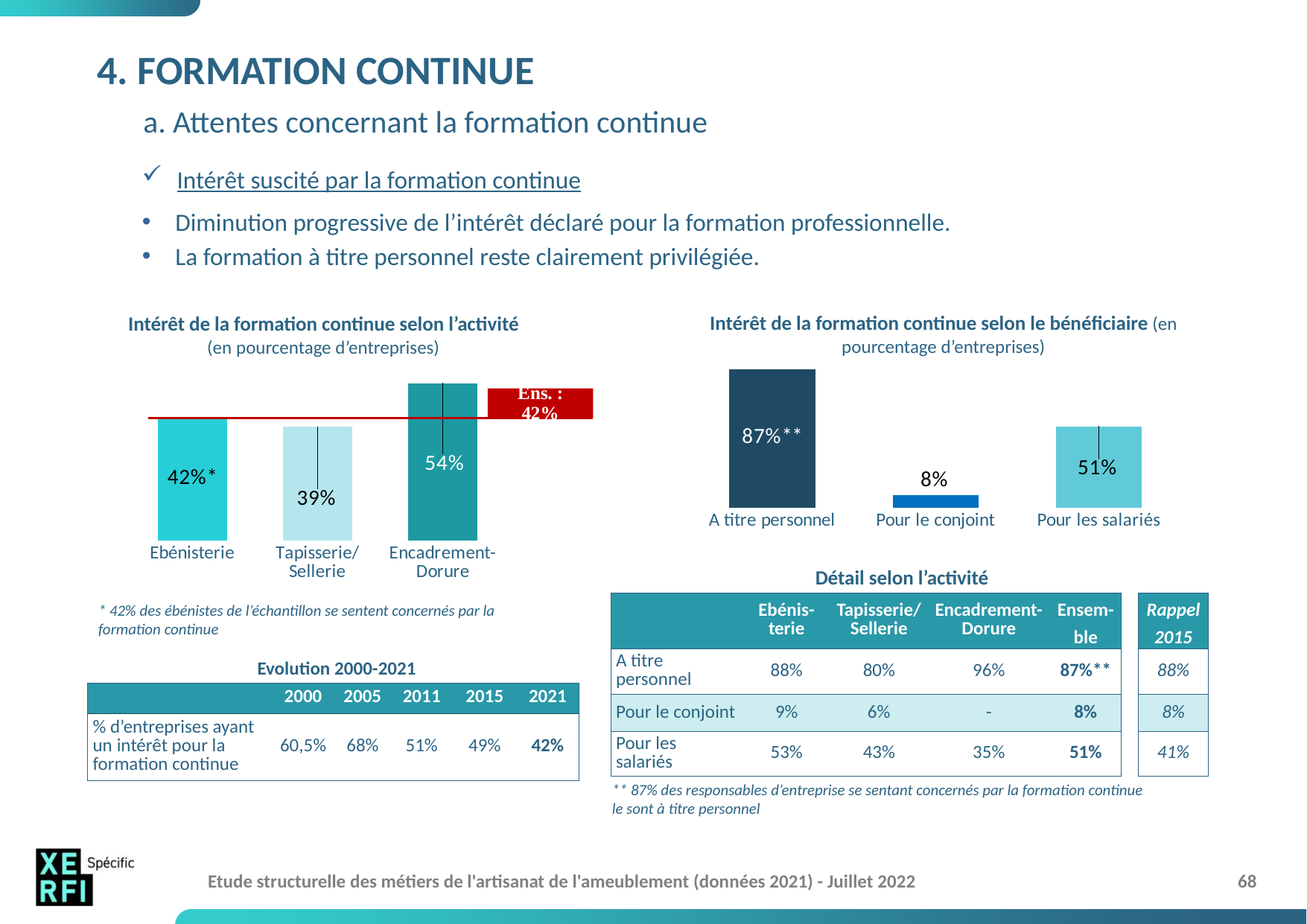
In the chart 'Intérêt de la formation continue selon l'activité', which activity has the highest value? Encadrement-Dorure In the chart 'Intérêt de la formation continue selon le bénéficiaire', what is the difference between 'A titre personnel' and 'Pour les salariés'? 36 percentage points In the chart 'Intérêt de la formation continue selon le bénéficiaire', which beneficiary has the highest value? A titre personnel What type of chart is 'Intérêt de la formation continue selon l'activité'? Bar chart In the chart 'Intérêt de la formation continue selon le bénéficiaire', what is the value for 'Pour le conjoint'? 8% In the chart 'Intérêt de la formation continue selon l'activité', which activity has the lowest value? Tapisserie/Sellerie How many categories are shown in the chart 'Intérêt de la formation continue selon le bénéficiaire'? 3 In the chart 'Intérêt de la formation continue selon le bénéficiaire', what is the value for 'Pour les salariés'? 51% In the chart 'Intérêt de la formation continue selon l'activité', what overall value ('Ens.') is marked by the red line? 42% In the chart 'Intérêt de la formation continue selon l'activité', what is the difference between Encadrement-Dorure and Ebénisterie? 12 percentage points In the chart 'Intérêt de la formation continue selon l'activité', what is the value for Tapisserie/Sellerie? 39% In the chart 'Intérêt de la formation continue selon l'activité', what is the value for Encadrement-Dorure? 54%